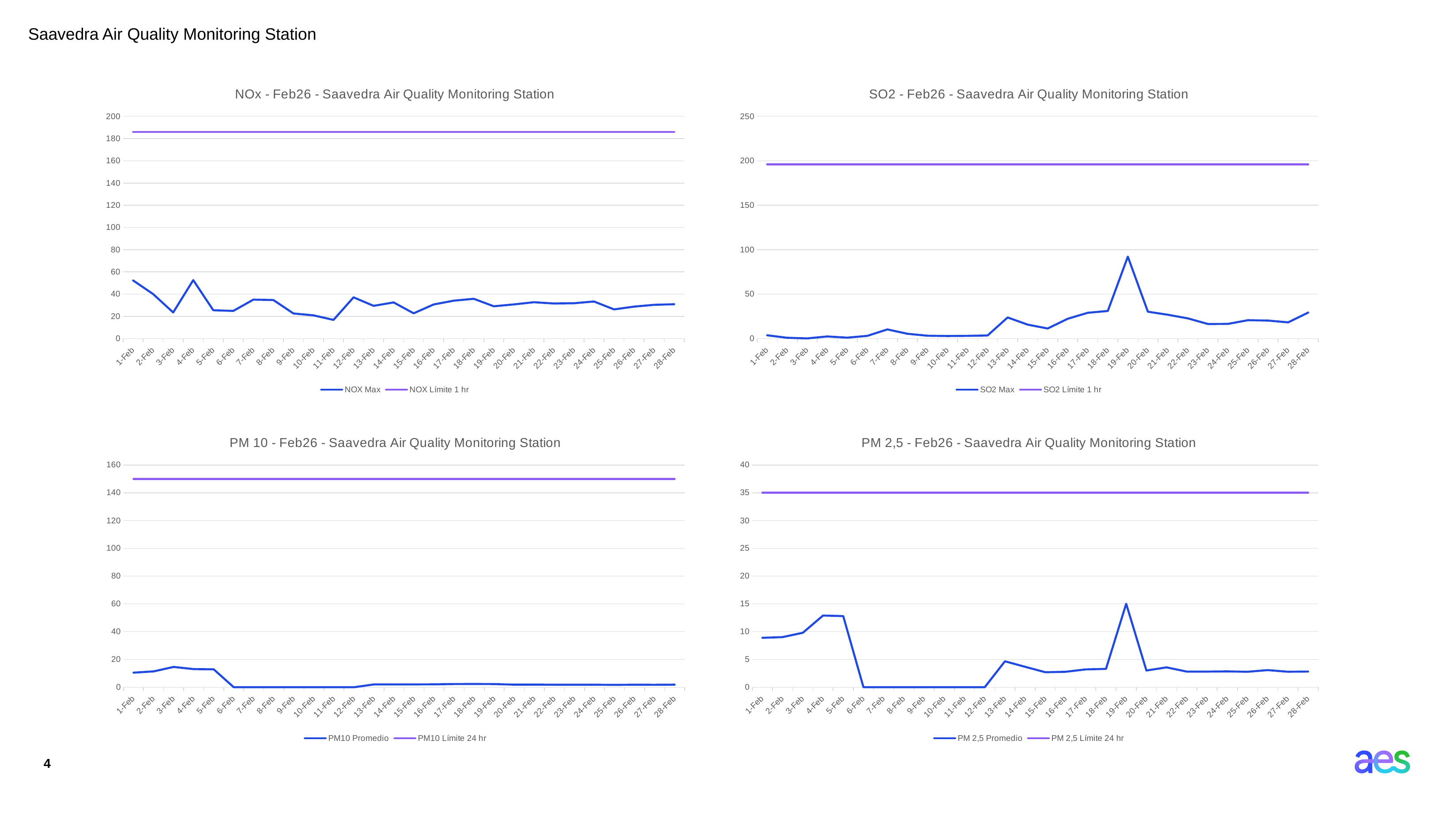
How many charts are shown on the slide? 4 In the PM 10 - Feb26 chart, on which date is the PM10 Promedio value highest? 3-Feb In the PM 10 - Feb26 chart, what is the PM10 Promedio value on 8-Feb? 0 In the NOx - Feb26 chart, on which date is the NOX Max value lowest? 11-Feb In the PM 2,5 - Feb26 chart, what is the value of the PM 2,5 Límite 24 hr line? 35 How many series does the legend of the SO2 - Feb26 chart list? 2 In the PM 2,5 - Feb26 chart, on which date is the PM 2,5 Promedio value highest? 19-Feb In the NOx - Feb26 chart, is the NOX Max value on 1-Feb greater or less than 40? greater In the SO2 - Feb26 chart, is the SO2 Max value on 19-Feb greater or less than 50? greater What kind of chart is the NOx - Feb26 chart? line chart In the SO2 - Feb26 chart, on which date is the SO2 Max value highest? 19-Feb How many dates are plotted along the x axis of the PM 10 - Feb26 chart? 28